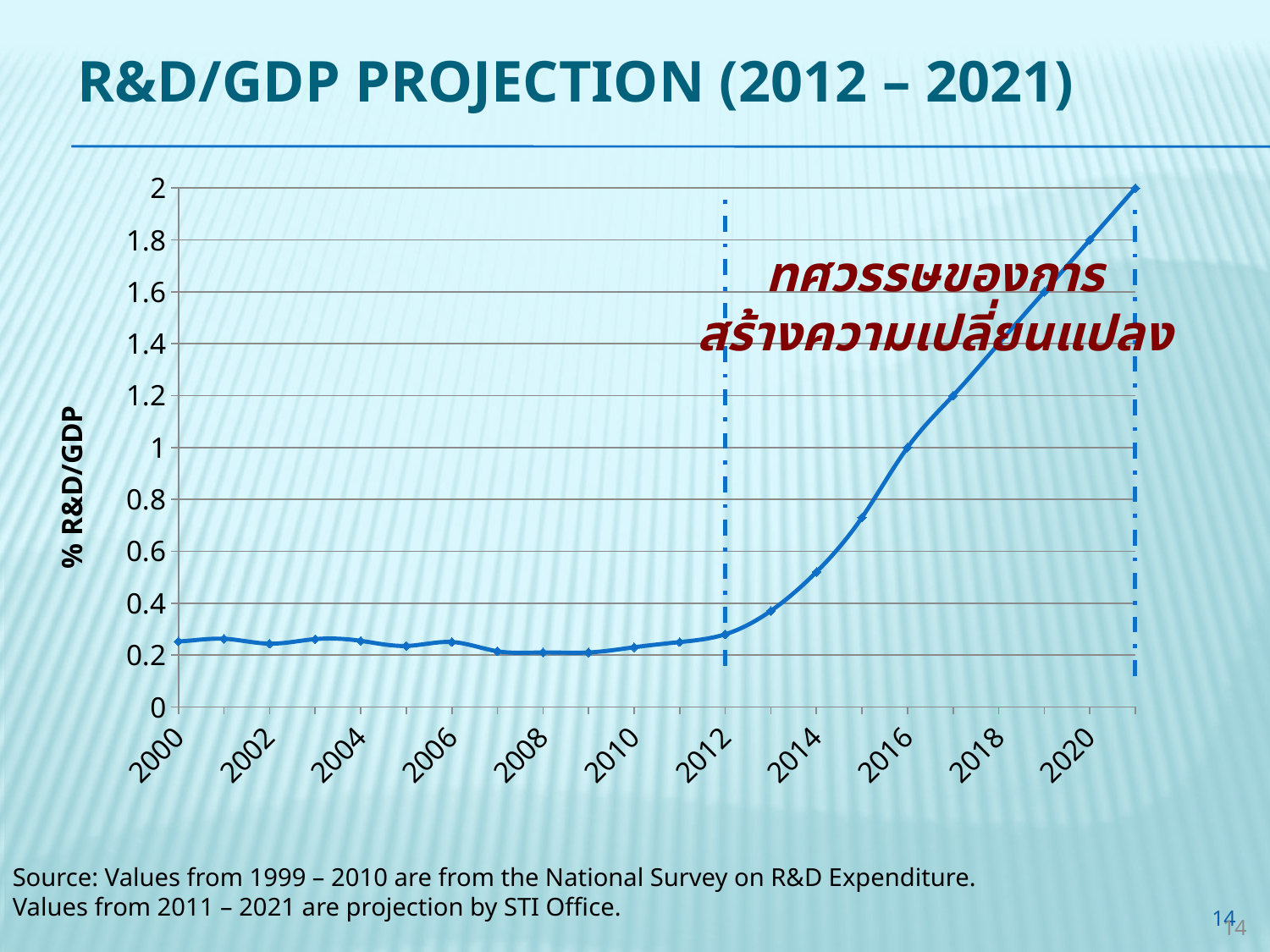
What is the title of the chart on the slide? R&D/GDP PROJECTION (2012 – 2021) What kind of chart is shown on the slide? line chart Is the value for 2015 greater or less than 0.6? greater Is the value for 2012 greater or less than 0.4? less What is the label of the vertical axis? % R&D/GDP What is the value of % R&D/GDP in 2021? 2 Is the value for 2000 greater or less than 0.4? less Which is larger, the value for 2010 or the value for 2018? 2018 Do the values rise or fall from 2012 to 2021? rise Which year has the highest % R&D/GDP value? 2021